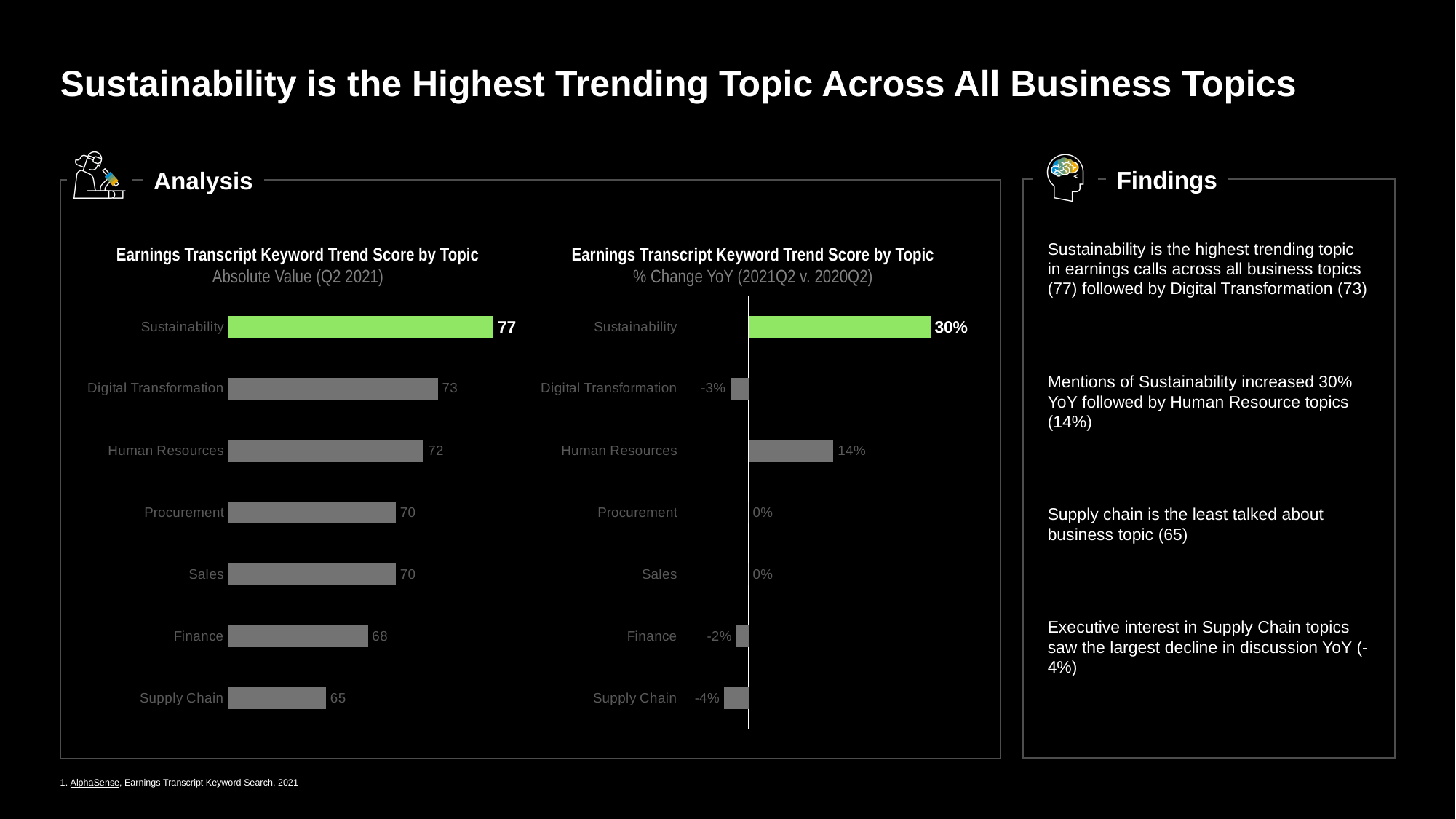
In the left chart (Absolute Value Q2 2021), what is the trend score for Sustainability? 77 In the right chart (% Change YoY), which topic has the lowest value? Supply Chain In the right chart (% Change YoY), what is the value for Sustainability? 30% In the left chart (Absolute Value Q2 2021), what is the trend score for Human Resources? 72 In the right chart (% Change YoY), what is the difference between the Sustainability value and the Human Resources value? 16% In the left chart (Absolute Value Q2 2021), how many topics are plotted? 7 In the left chart (Absolute Value Q2 2021), which topic has the lowest trend score? Supply Chain In the left chart (Absolute Value Q2 2021), what is the difference between the Sustainability score and the Supply Chain score? 12 In the right chart (% Change YoY), what is the value for Digital Transformation? -3% What kind of chart is the left chart (Absolute Value Q2 2021)? Bar chart In the right chart (% Change YoY), which bar is highlighted in green? Sustainability In the right chart (% Change YoY), which is larger, the value for Human Resources or the value for Finance? Human Resources